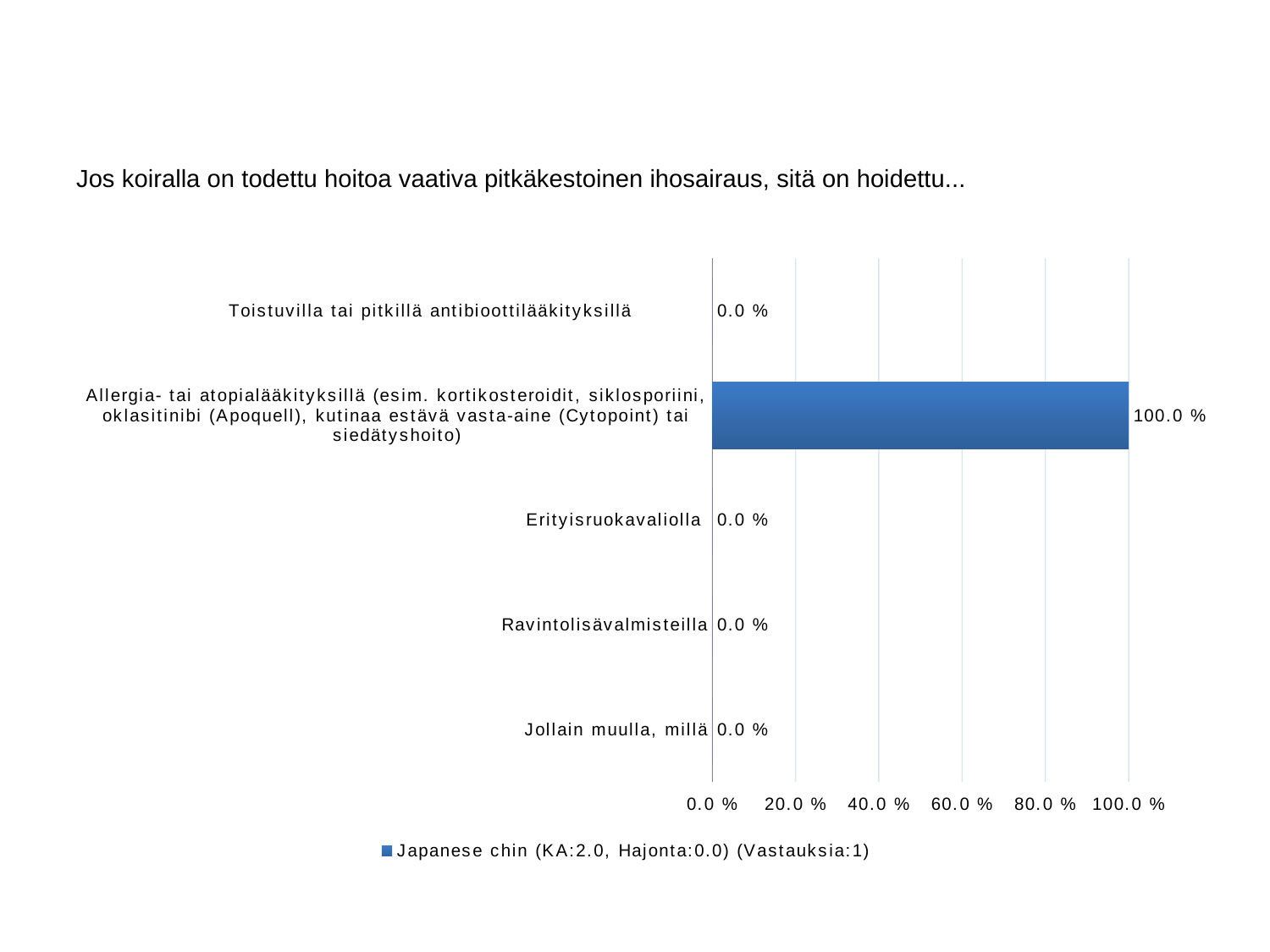
What type of chart is shown on the slide? bar chart What is the legend entry for the series shown? Japanese chin (KA:2.0, Hajonta:0.0) (Vastauksia:1) Which is larger: the value for "Allergia- tai atopialääkityksillä" or the value for "Erityisruokavaliolla"? Allergia- tai atopialääkityksillä How many series does the legend list? 1 What is the value for the "Allergia- tai atopialääkityksillä" category? 100.0 % How many categories are shown on the chart? 5 What is the value for "Toistuvilla tai pitkillä antibioottilääkityksillä"? 0.0 % What is the value for "Jollain muulla, millä"? 0.0 % What is the title of the chart? Jos koiralla on todettu hoitoa vaativa pitkäkestoinen ihosairaus, sitä on hoidettu... What is the difference between the values for "Allergia- tai atopialääkityksillä" and "Ravintolisävalmisteilla"? 100.0 % What is the value for "Erityisruokavaliolla"? 0.0 % Which category has the highest value? Allergia- tai atopialääkityksillä (esim. kortikosteroidit, siklosporiini, oklasitinibi (Apoquell), kutinaa estävä vasta-aine (Cytopoint) tai siedätyshoito)